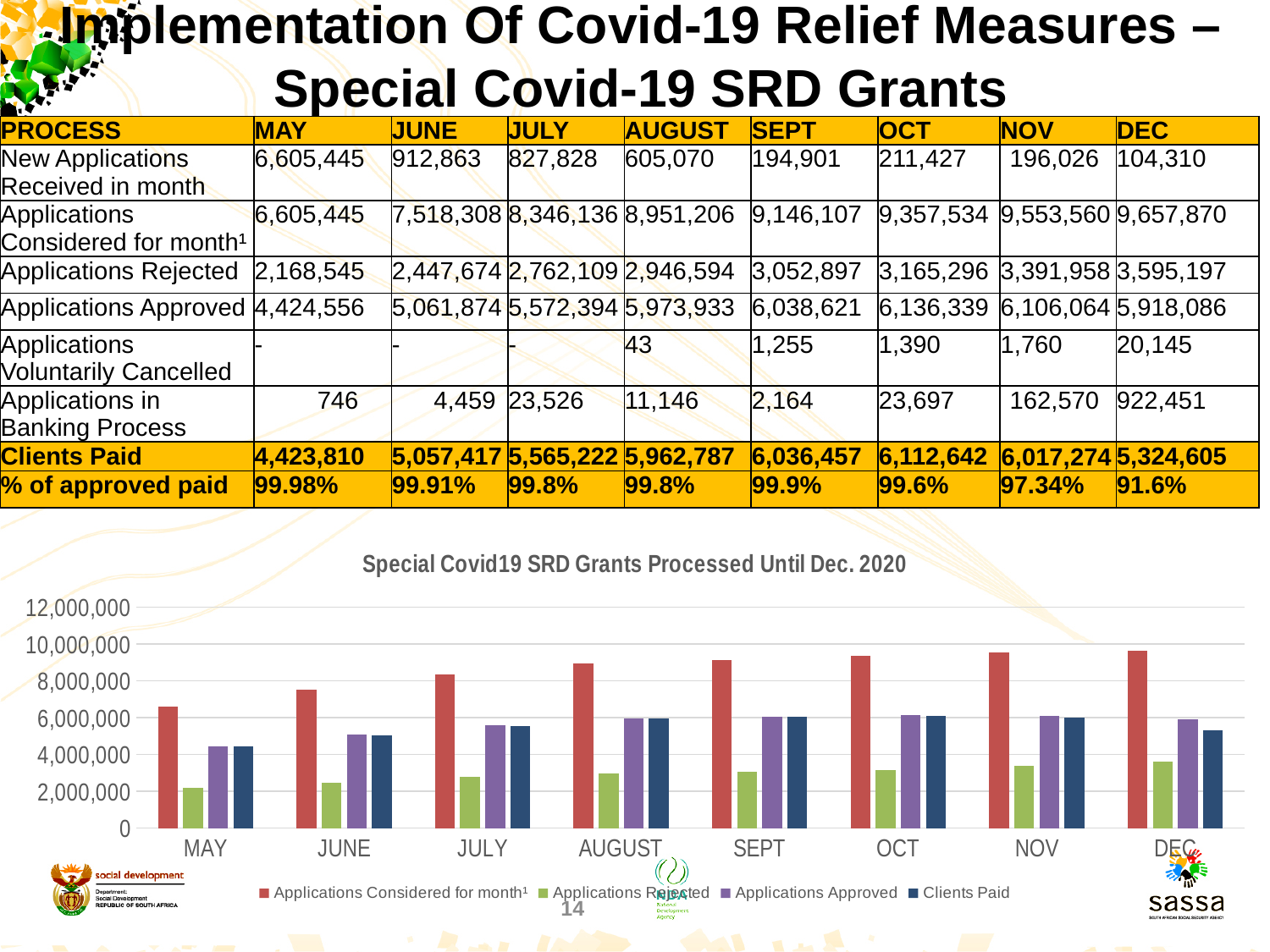
What kind of chart is shown under the title 'Special Covid19 SRD Grants Processed Until Dec. 2020'? Bar chart In which month is the Clients Paid bar the shortest in the chart? MAY How many months are shown along the x axis of the chart? 8 In MAY, which is larger: Applications Rejected or Applications Approved? Applications Approved What is the Clients Paid value for DEC shown on the slide? 5,324,605 Is the Applications Considered for month value for SEPT greater or less than 10,000,000? less Do the Applications Considered for month bars rise or fall from MAY to DEC? Rise Is the Applications Rejected value for DEC greater or less than 4,000,000? less What is the difference between Applications Considered for month and Clients Paid in DEC, using the values printed on the slide? 4,333,265 What colour are the Clients Paid bars in the chart? Dark blue In which month is the Applications Considered for month bar the tallest in the chart? DEC How many series does the legend of the chart list? 4